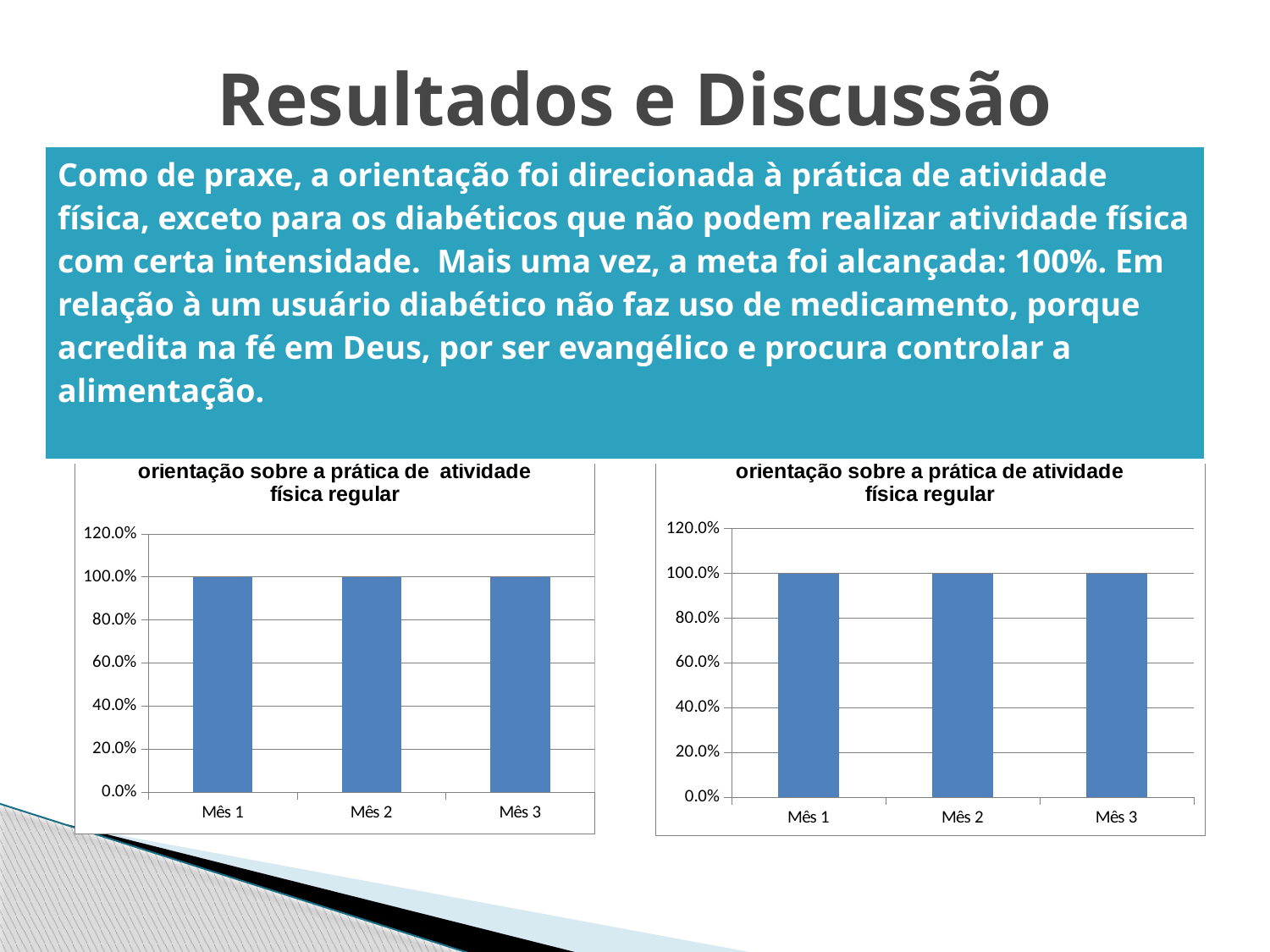
In the left chart, what is the value for Mês 1? 100.0% What kind of chart is the left chart on the slide? bar chart In the left chart, how many categories are shown on the x axis? 3 In the right chart, what is the value for Mês 3? 100.0% What kind of chart is the right chart on the slide? bar chart In the left chart, is the value for Mês 2 greater or less than 80.0%? greater In the right chart, do the values rise, fall or stay the same across the months? stay the same What is the label of the first category on the x axis of the right chart? Mês 1 In the right chart, is the value for Mês 1 greater or less than 120.0%? less In the left chart, do the values rise, fall or stay the same from Mês 1 to Mês 3? stay the same In the right chart, how many bars are plotted? 3 What is the title of the left chart? orientação sobre a prática de atividade física regular